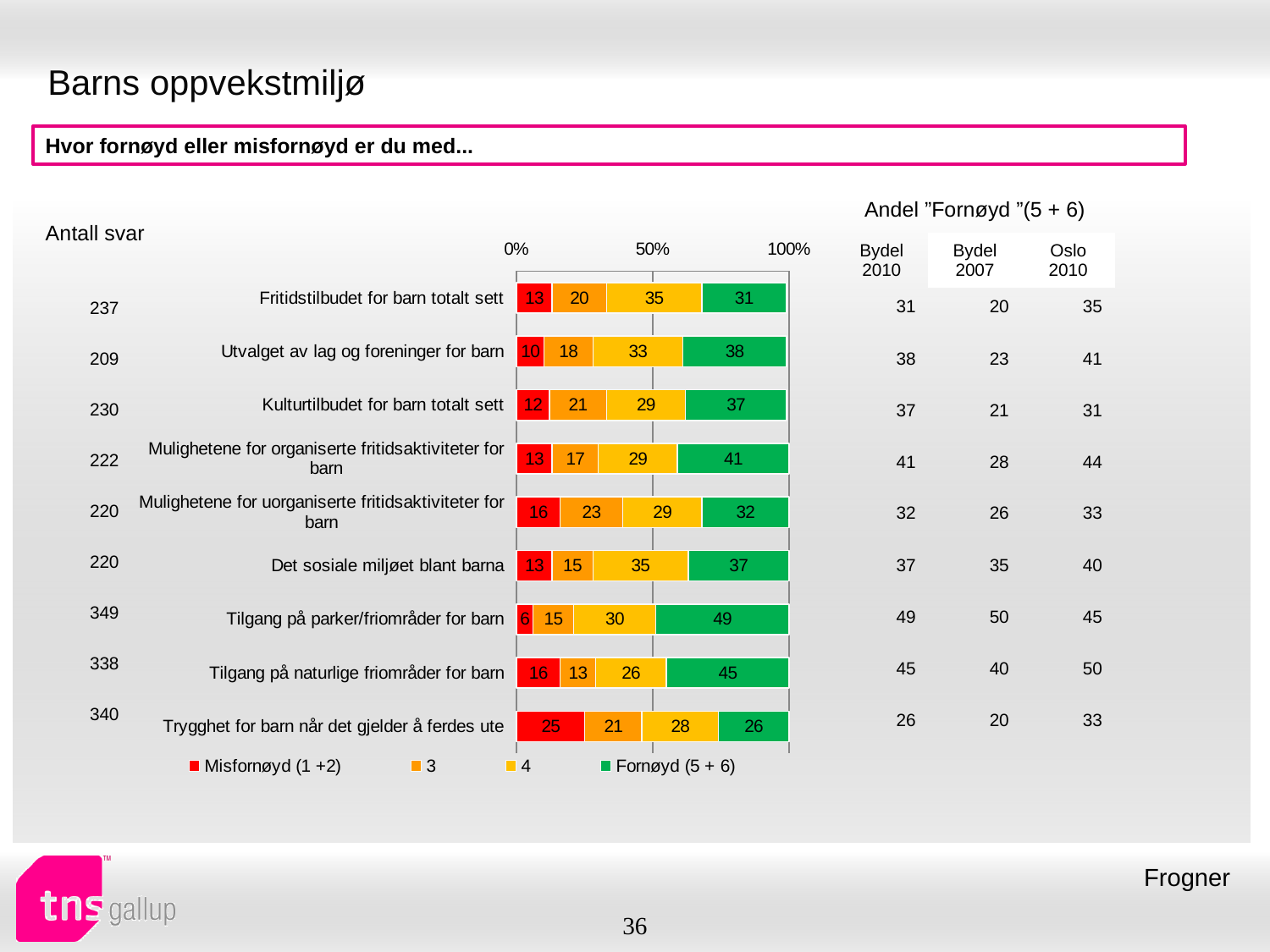
Which legend entry is shown in green? Fornøyd (5 + 6) What is the value of the "4" segment for "Det sosiale miljøet blant barna"? 35 Which category has the highest "Fornøyd (5 + 6)" value? Tilgang på parker/friområder for barn What is the value of the "Misfornøyd (1 +2)" segment for "Trygghet for barn når det gjelder å ferdes ute"? 25 How many series does the legend list? 4 Which category has the lowest "Fornøyd (5 + 6)" value? Trygghet for barn når det gjelder å ferdes ute Which is larger: the "Misfornøyd (1 +2)" value for "Mulighetene for uorganiserte fritidsaktiviteter for barn" or for "Tilgang på parker/friområder for barn"? Mulighetene for uorganiserte fritidsaktiviteter for barn How many categories are shown in the chart? 9 What is the value of the "Fornøyd (5 + 6)" segment for "Tilgang på parker/friområder for barn"? 49 What is the difference between the "Fornøyd (5 + 6)" values for "Tilgang på naturlige friområder for barn" and "Fritidstilbudet for barn totalt sett"? 14 What is the total of the stacked bar for "Utvalget av lag og foreninger for barn"? 99 What kind of chart is shown on the slide? Stacked bar chart